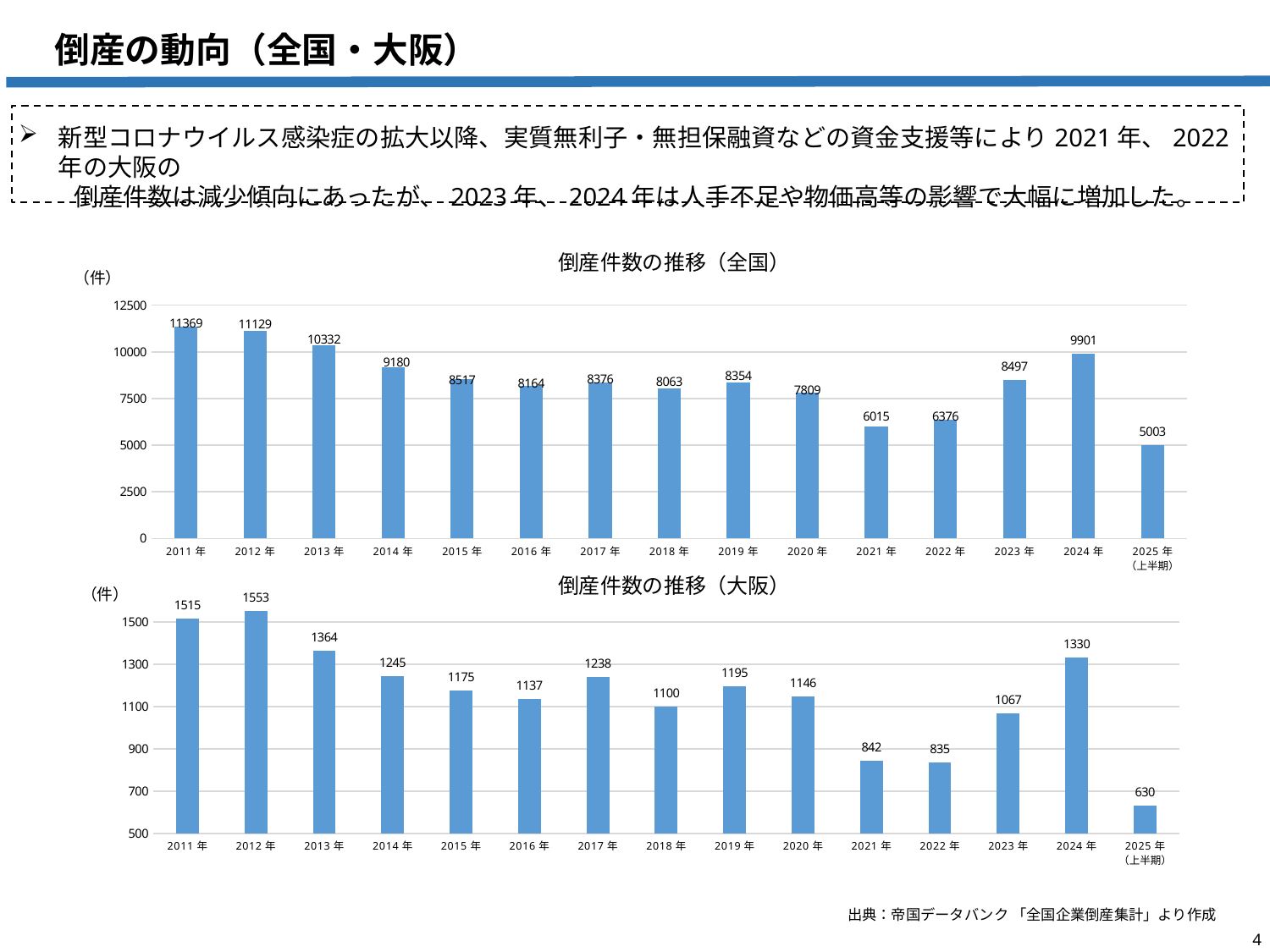
In the 倒産件数の推移（全国） chart, how many bars are plotted? 15 In the 倒産件数の推移（全国） chart, what is the value for 2021年? 6015 In the 倒産件数の推移（全国） chart, which year has the highest value? 2011年 In the 倒産件数の推移（全国） chart, what is the difference between the values for 2024年 and 2023年? 1404 In the 倒産件数の推移（大阪） chart, do the values rise or fall from 2022年 to 2024年? rise In the 倒産件数の推移（全国） chart, which category has the lowest value? 2025年（上半期） In the 倒産件数の推移（大阪） chart, what is the difference between the values for 2011年 and 2012年? 38 In the 倒産件数の推移（大阪） chart, what is the value for 2024年? 1330 In the 倒産件数の推移（全国） chart, is the value for 2020年 greater or less than 7500? greater In the 倒産件数の推移（大阪） chart, which is larger, the value for 2021年 or 2022年? 2021年 In the 倒産件数の推移（大阪） chart, which year has the highest value? 2012年 What kind of chart is the 倒産件数の推移（大阪） chart? bar chart